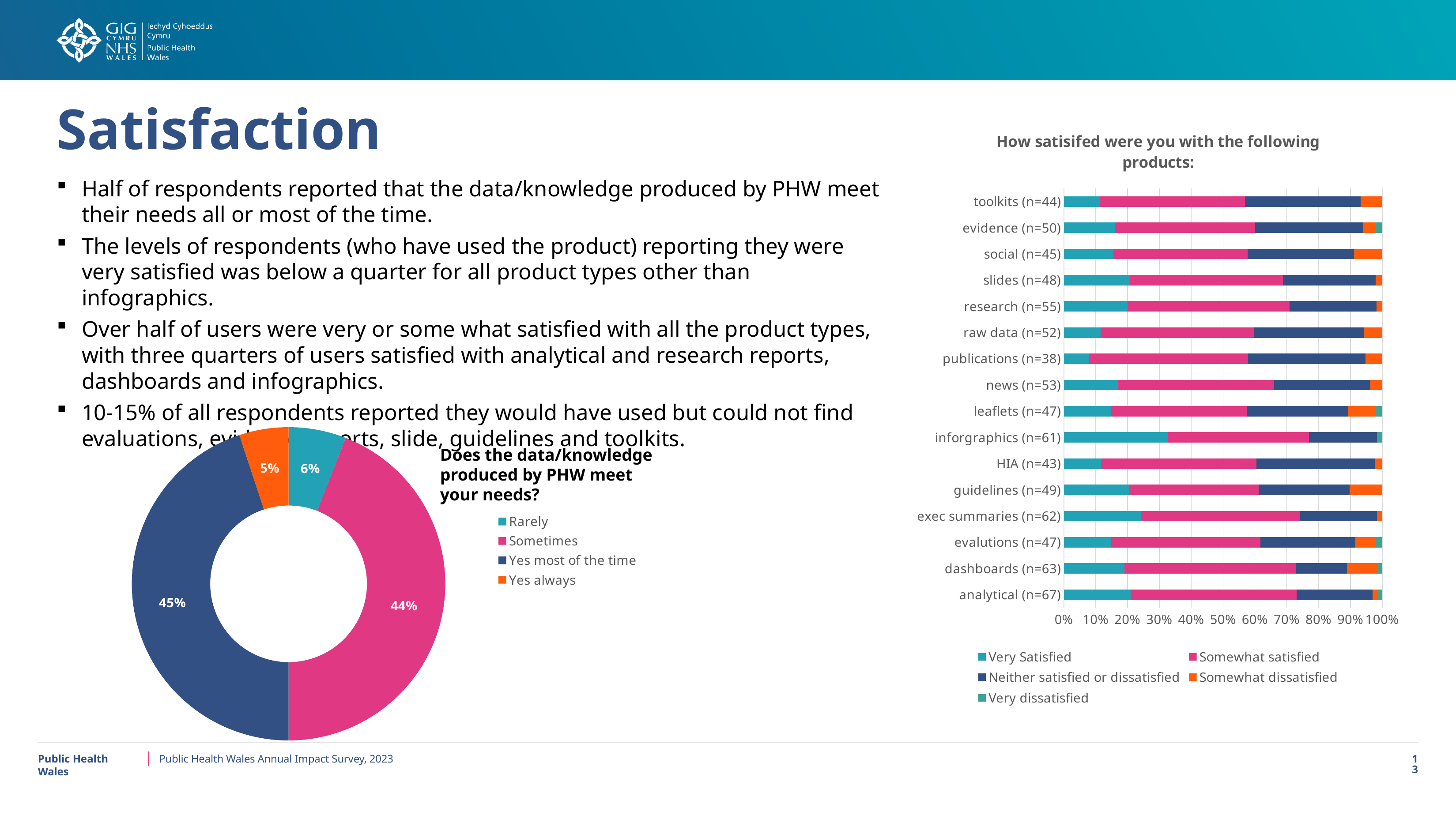
On the donut chart 'Does the data/knowledge produced by PHW meet your needs?', what percentage answered 'Rarely'? 6% On the chart 'How satisfied were you with the following products:', how many series does the legend list? 5 On the chart 'How satisfied were you with the following products:', which product has the largest 'Very Satisfied' share? inforgraphics (n=61) On the donut chart 'Does the data/knowledge produced by PHW meet your needs?', what percentage answered 'Sometimes'? 44% On the donut chart 'Does the data/knowledge produced by PHW meet your needs?', which response has the largest share? Yes most of the time On the donut chart 'Does the data/knowledge produced by PHW meet your needs?', how many response categories are shown? 4 On the donut chart 'Does the data/knowledge produced by PHW meet your needs?', what is the difference in percentage points between 'Yes most of the time' and 'Sometimes'? 1 percentage point On the chart 'How satisfied were you with the following products:', what kind of chart is it? Stacked bar chart On the chart 'How satisfied were you with the following products:', how many product categories are listed? 16 On the donut chart 'Does the data/knowledge produced by PHW meet your needs?', what percentage answered 'Yes always'? 5% On the donut chart 'Does the data/knowledge produced by PHW meet your needs?', which response has the smallest share? Yes always On the chart 'How satisfied were you with the following products:', is the 'Very Satisfied' share for toolkits (n=44) greater or less than 20%? less